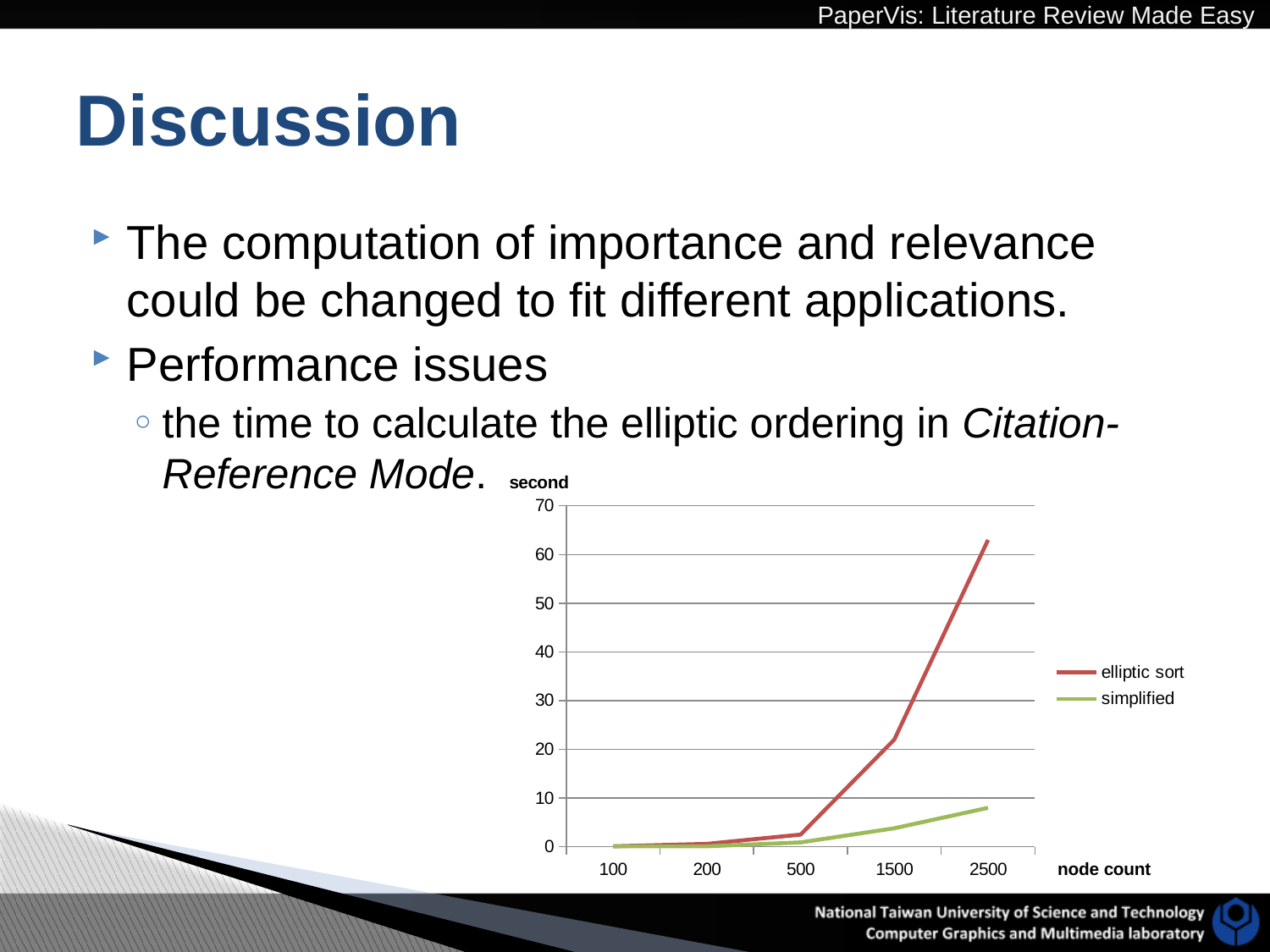
How many node count values are plotted along the x axis? 5 At which node count does the elliptic sort series reach its highest value? 2500 Is the value for elliptic sort at 2500 nodes greater or less than 50? greater What colour is the line for the elliptic sort series? red Is the value for elliptic sort at 500 nodes greater or less than 10? less Is the value for elliptic sort at 1500 nodes greater or less than 30? less How many series does the chart's legend list? 2 What is the label on the y axis of the chart? second At 2500 nodes, which series has the higher value, elliptic sort or simplified? elliptic sort What kind of chart is shown on the slide? line chart Do the values for elliptic sort rise or fall as node count increases? rise